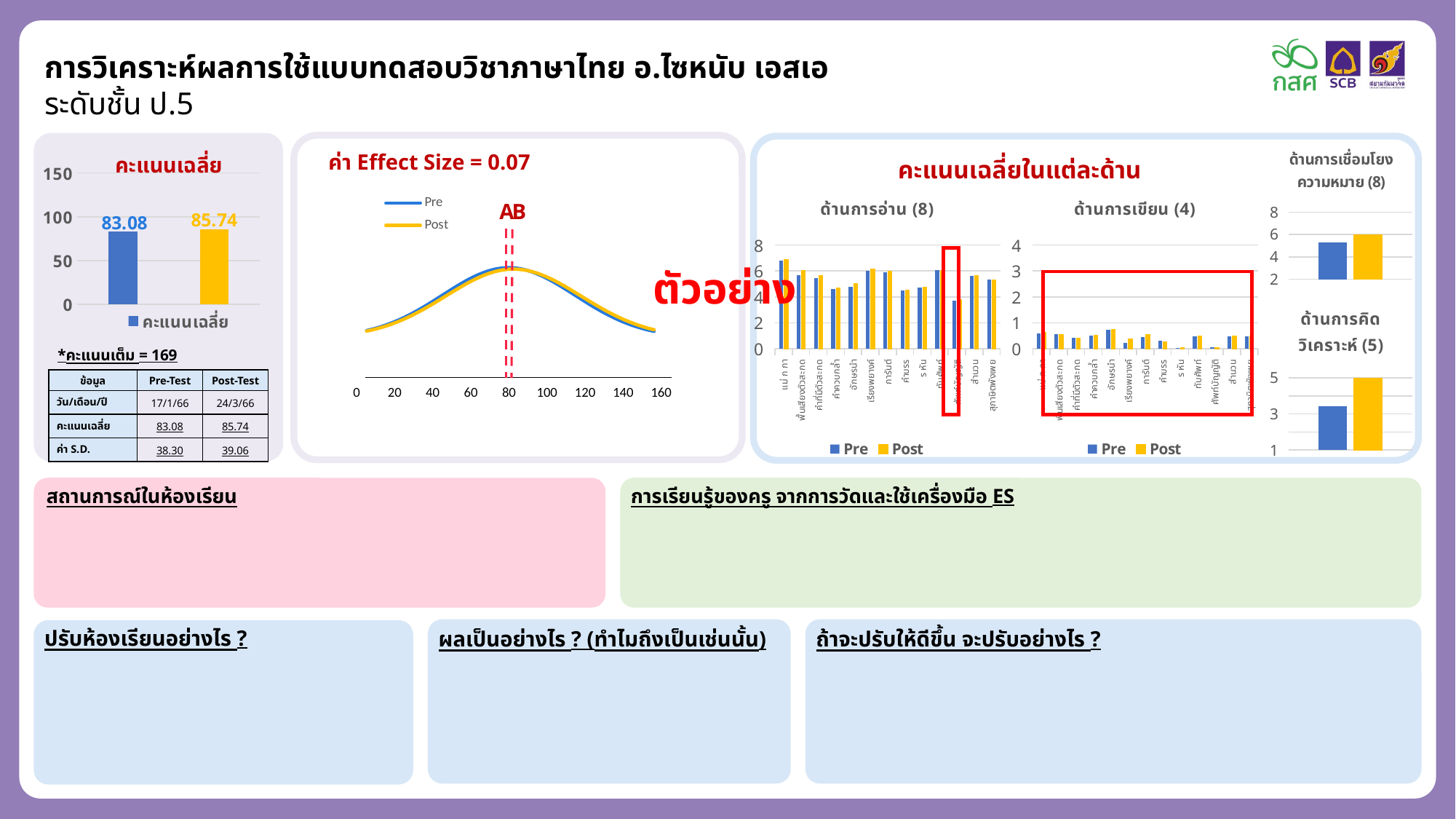
What kind of chart is the ค่า Effect Size chart in the middle of the slide? Line chart How many series does the legend of the ค่า Effect Size chart list? 2 What Effect Size value is printed above the line chart in the middle of the slide? 0.07 In the คะแนนเฉลี่ย chart, how many bars are plotted? 2 In the คะแนนเฉลี่ย bar chart, what is the difference between the yellow bar (85.74) and the blue bar (83.08)? 2.66 In the ด้านการคิดวิเคราะห์ (5) chart on the right, which bar is larger, Pre or Post? Post In the คะแนนเฉลี่ย bar chart, what is the value of the yellow bar? 85.74 In the คะแนนเฉลี่ย bar chart, what is the value of the blue bar? 83.08 In the ด้านการเชื่อมโยงความหมาย (8) chart on the right, is the Pre value greater or less than 4? greater In the คะแนนเฉลี่ย bar chart, which bar is larger, the blue one or the yellow one? The yellow bar (85.74) In the คะแนนเฉลี่ย bar chart, is the value of the blue bar greater or less than 100? less What kind of chart is the คะแนนเฉลี่ย chart on the left? Bar chart